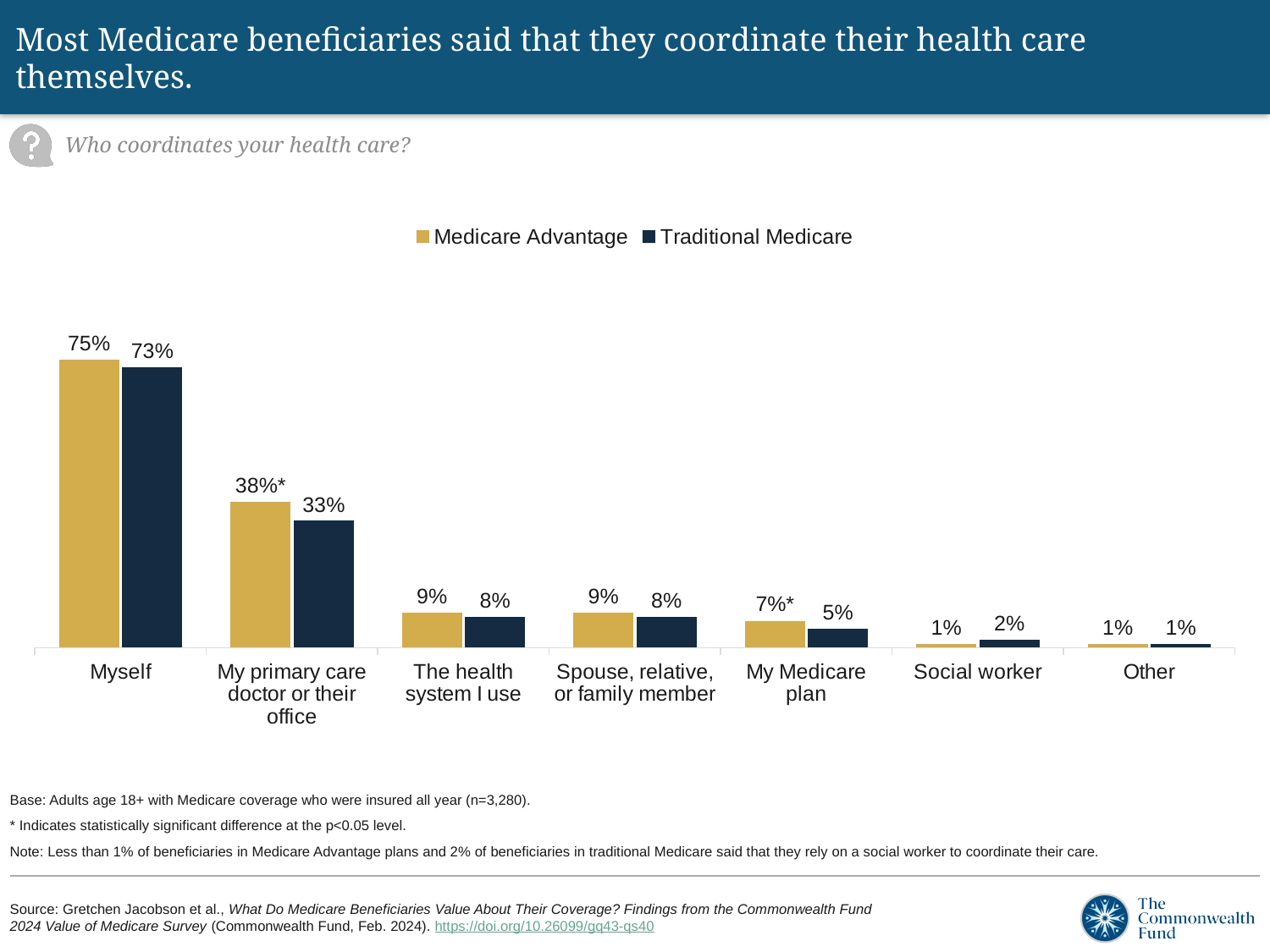
What percentage of Medicare Advantage beneficiaries said they coordinate their health care themselves (Myself)? 75% Which category has the highest value for Traditional Medicare? Myself What is the difference between the Medicare Advantage and Traditional Medicare values for 'My primary care doctor or their office'? 5 percentage points How many series does the legend list? 2 What percentage of Traditional Medicare beneficiaries said their primary care doctor or their office coordinates their health care? 33% Which series is shown in gold/yellow in the chart? Medicare Advantage What is the Traditional Medicare value for 'My Medicare plan'? 5% How many categories are shown on the x axis of the chart? 7 For 'Social worker', which series has the larger value, Medicare Advantage or Traditional Medicare? Traditional Medicare What is the difference between the Medicare Advantage values for 'Myself' and 'The health system I use'? 66 percentage points Which categories have a Medicare Advantage value marked with an asterisk indicating a statistically significant difference? My primary care doctor or their office; My Medicare plan What kind of chart is shown on the slide? Bar chart